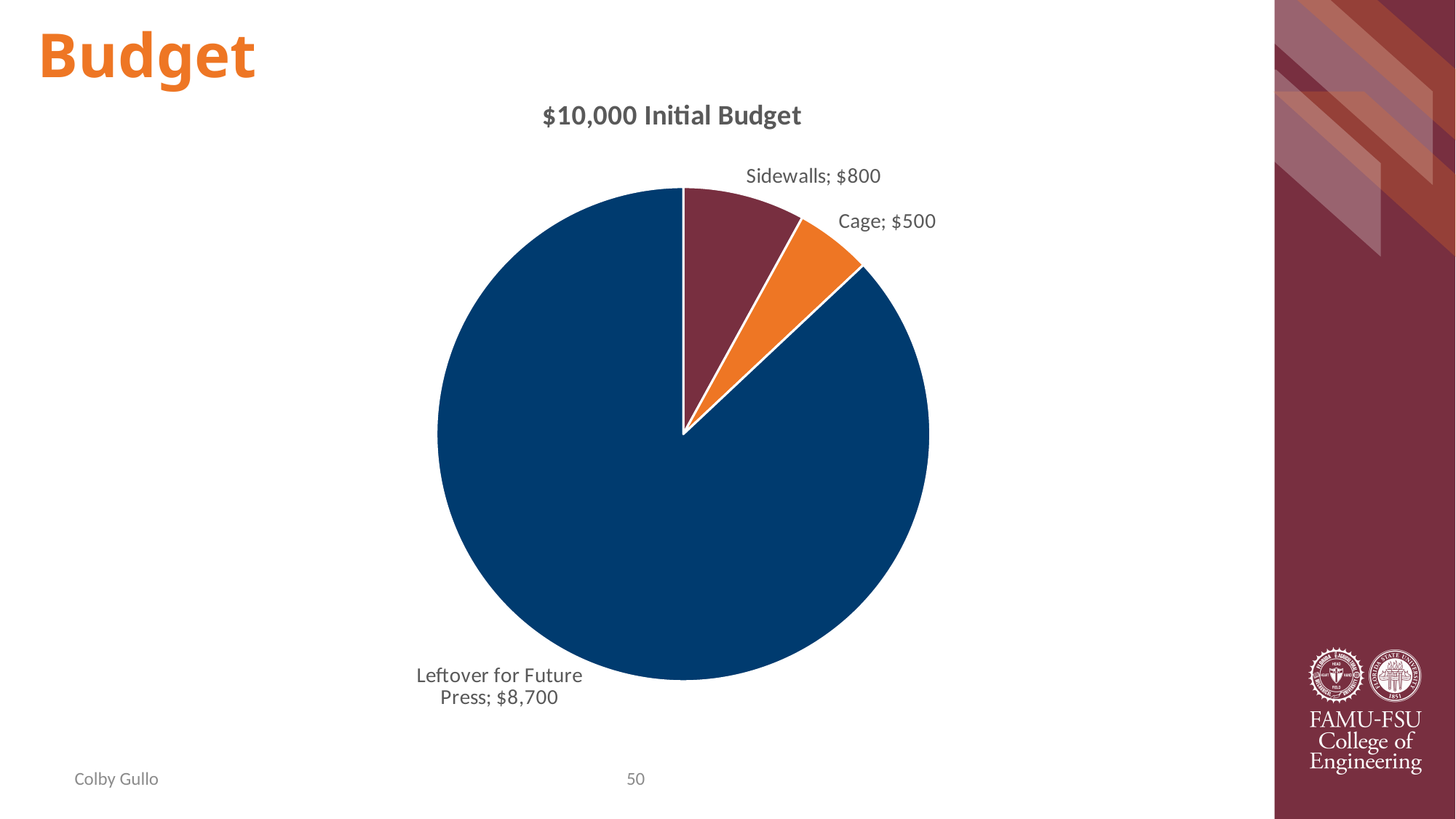
How many slices does the pie chart have? 3 Which slice is the largest? Leftover for Future Press What share of the pie does Sidewalls represent? 8% What is the difference between Sidewalls and Cage? $300 What is the value for Leftover for Future Press? $8,700 What is the value for Sidewalls? $800 What kind of chart is shown? Pie chart What is the value for Cage? $500 What is the difference between Leftover for Future Press and Sidewalls? $7,900 Which slice is the smallest? Cage Which is larger, Sidewalls or Cage? Sidewalls What is the title of the chart? $10,000 Initial Budget